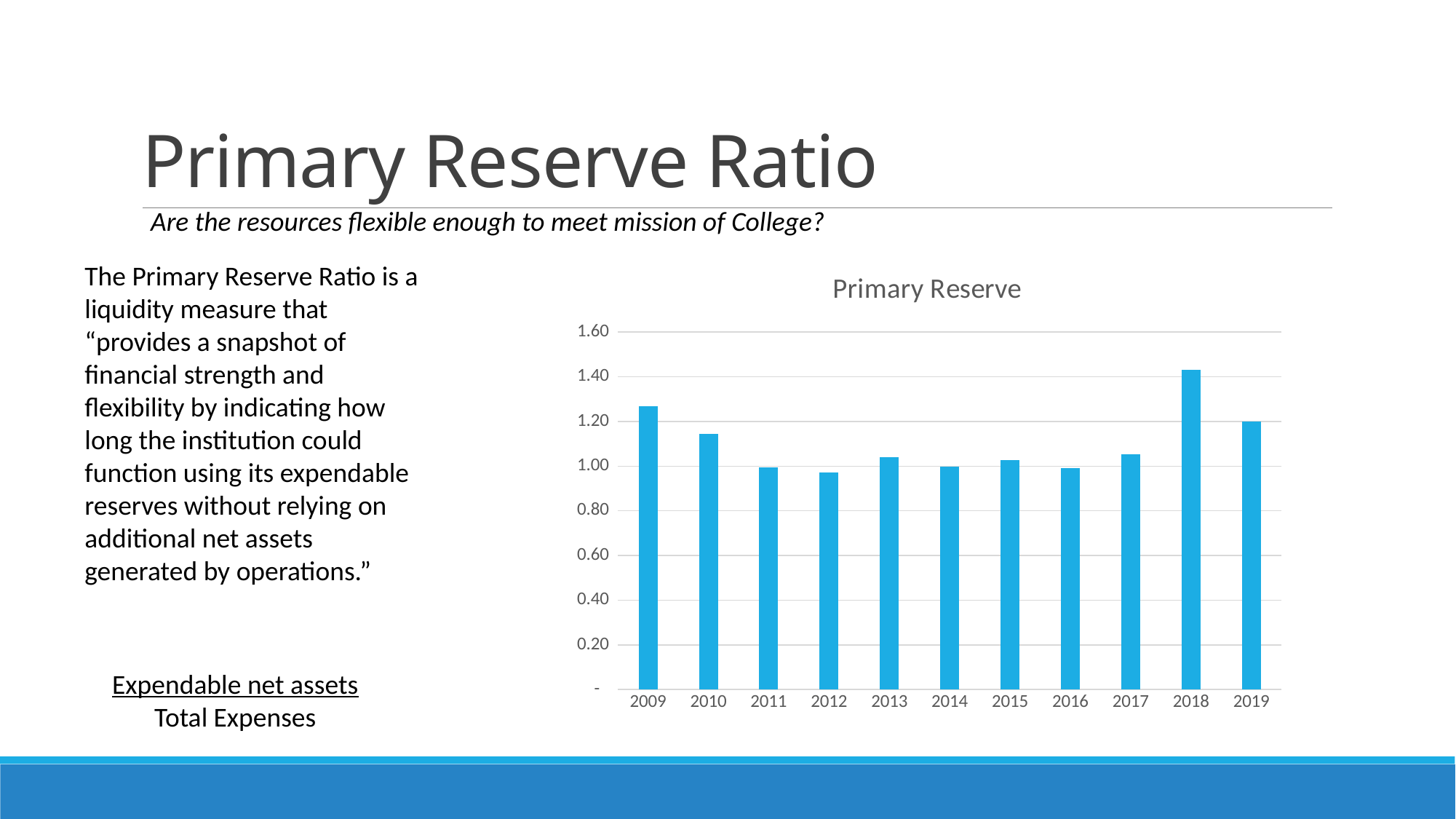
Is the value for 2019 greater or less than 1.00? greater Is the value for 2012 greater or less than 1.00? less What is the title of the chart? Primary Reserve Which year has the larger value, 2018 or 2019? 2018 Which year has the larger value, 2009 or 2010? 2009 How many years are plotted on the chart? 11 Is the value for 2018 greater or less than 1.20? greater Which year has the highest Primary Reserve value? 2018 Do the values rise or fall from 2009 to 2012? fall Do the values rise or fall from 2016 to 2018? rise What kind of chart is shown on the slide? Bar chart